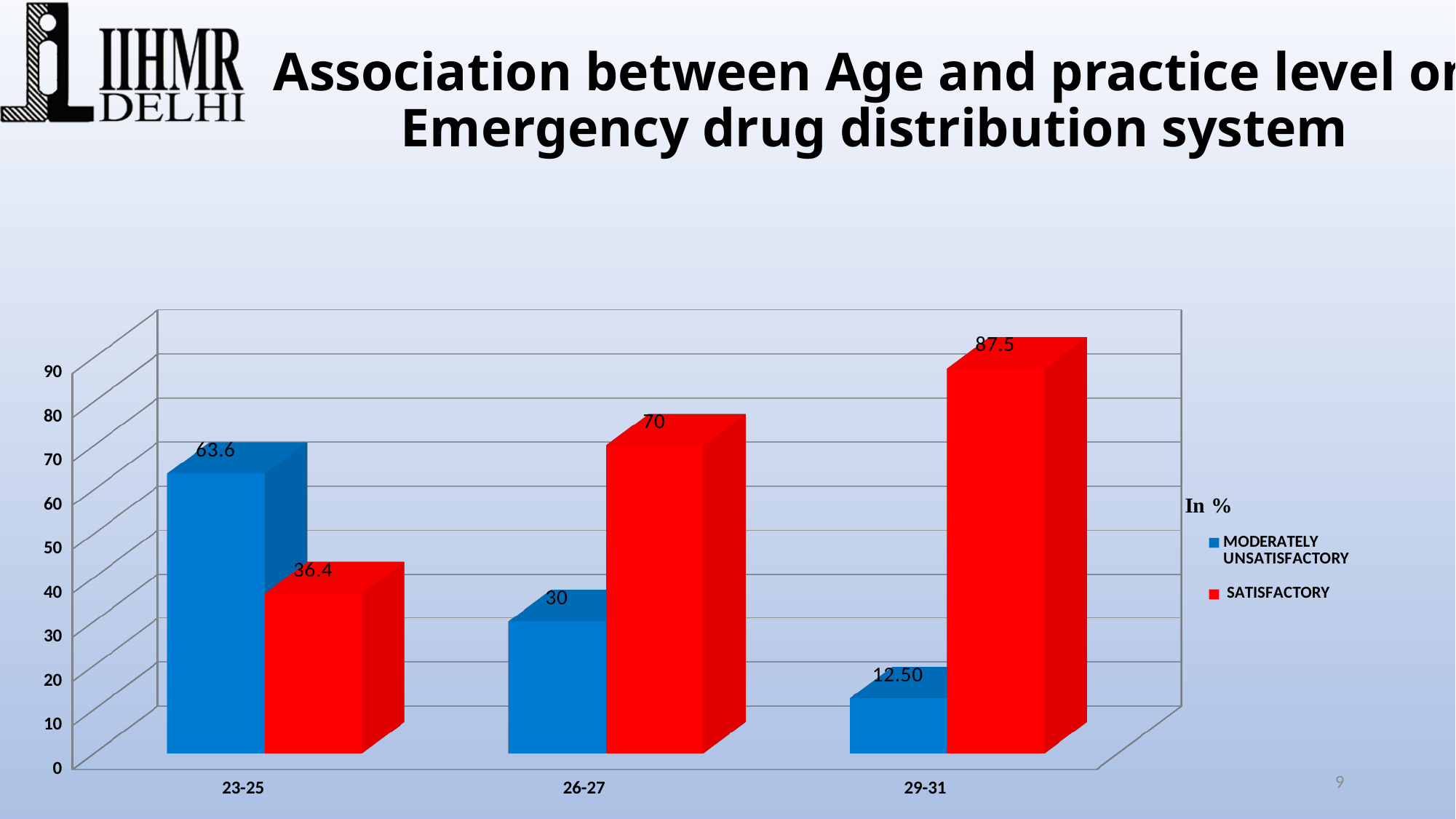
Which age group has the highest Satisfactory value? 29-31 What is the difference between the Satisfactory and Moderately Unsatisfactory values for the 26-27 age group? 40 What kind of chart is shown on the slide? Bar chart Which age group has the lowest Moderately Unsatisfactory value? 29-31 What is the Moderately Unsatisfactory value for the 29-31 age group? 12.50 For the 23-25 age group, which is larger: Moderately Unsatisfactory or Satisfactory? Moderately Unsatisfactory Do the Satisfactory values rise or fall across the age groups from 23-25 to 29-31? Rise How many age groups are shown on the x axis? 3 What is the Satisfactory value for the 26-27 age group? 70 What is the Satisfactory value for the 29-31 age group? 87.5 What is the Moderately Unsatisfactory value for the 23-25 age group? 63.6 How many series does the legend list? 2